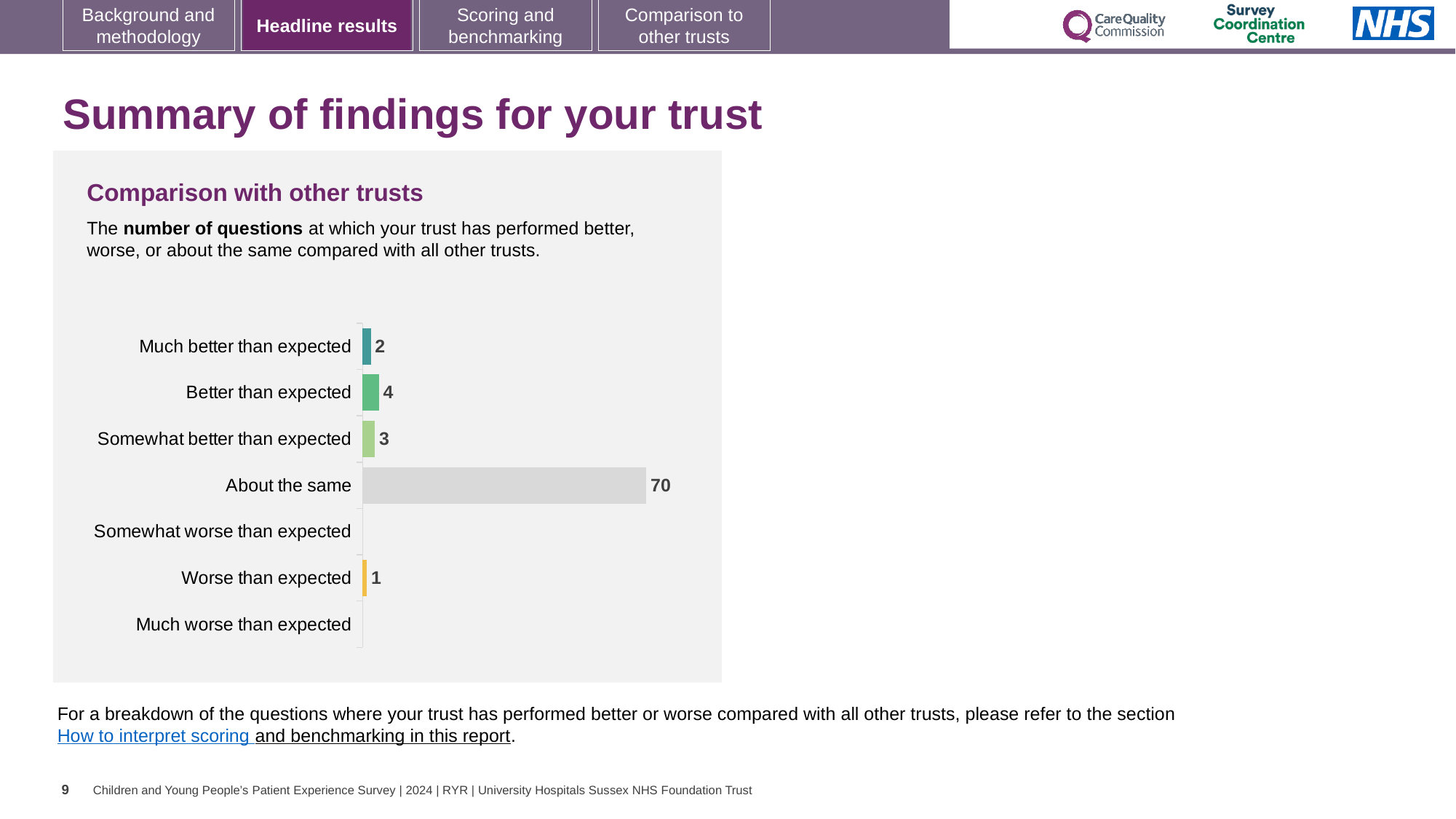
What is the value for 'Better than expected'? 4 What is the difference between the values for 'About the same' and 'Better than expected'? 66 What is the difference between the values for 'Better than expected' and 'Somewhat better than expected'? 1 Which category has the highest value? About the same What is the total of the values for 'Much better than expected', 'Better than expected' and 'Somewhat better than expected'? 9 What is the value for 'About the same'? 70 How many categories are shown on the chart? 7 What kind of chart is shown on the slide? Bar chart What is the title of the chart? Comparison with other trusts Which is larger, the value for 'Better than expected' or the value for 'Much better than expected'? Better than expected What is the value for 'Much better than expected'? 2 What is the value for 'Worse than expected'? 1